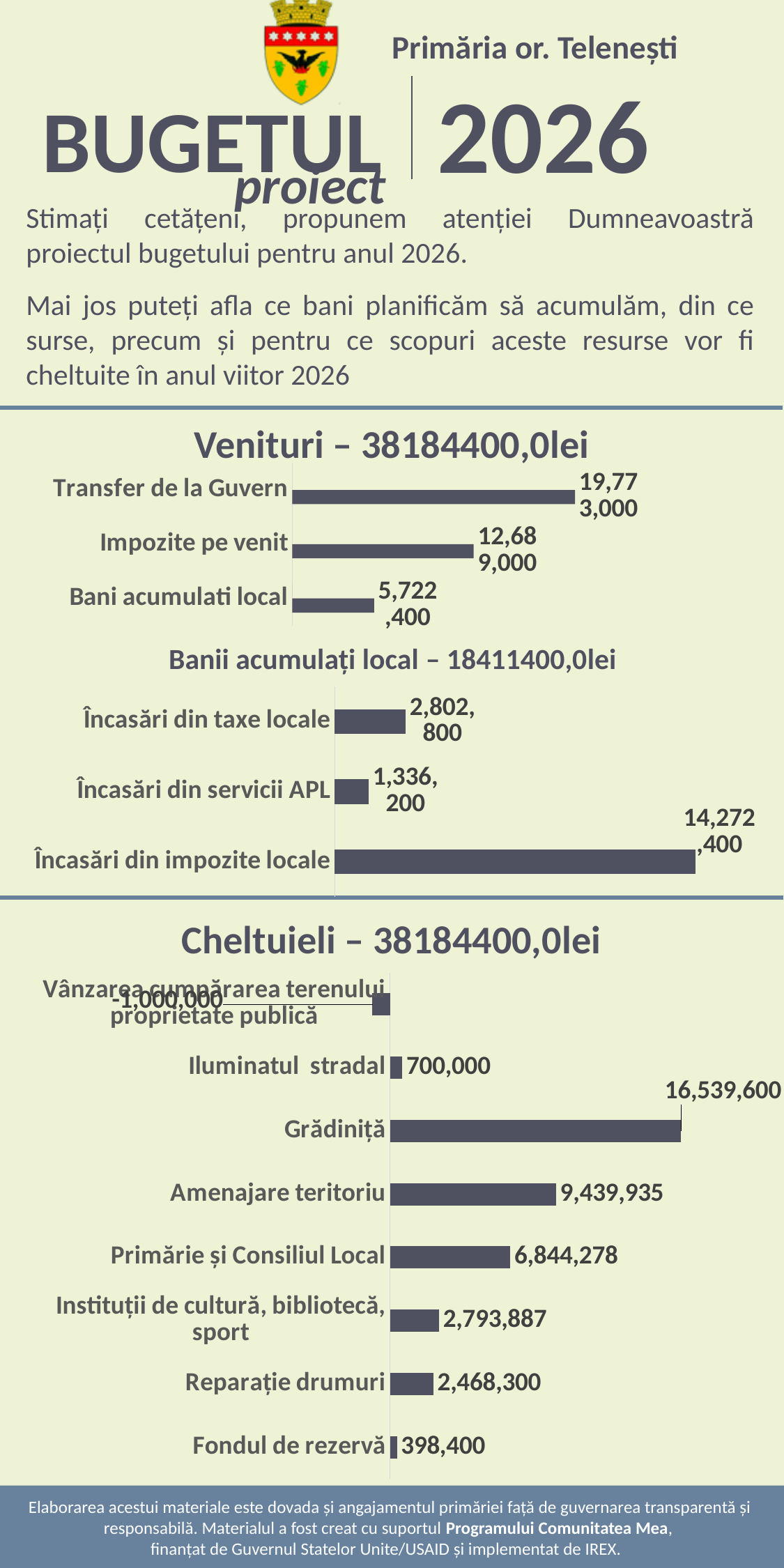
In the 'Cheltuieli' chart, which is larger: Amenajare teritoriu or Primărie și Consiliul Local? Amenajare teritoriu In the 'Cheltuieli' chart, what is the value for Reparație drumuri? 2,468,300 What kind of chart is the 'Cheltuieli' chart? Bar chart In the 'Banii acumulați local' chart, what is the difference between Încasări din taxe locale and Încasări din servicii APL? 1,466,600 In the 'Venituri' chart, which category has the lowest value? Bani acumulati local In the 'Banii acumulați local' chart, what is the value for Încasări din servicii APL? 1,336,200 In the 'Cheltuieli' chart, what is the value for Grădiniță? 16,539,600 In the 'Venituri' chart, how many categories are shown? 3 In the 'Banii acumulați local' chart, which category has the highest value? Încasări din impozite locale In the 'Venituri' chart, what is the value for Impozite pe venit? 12,689,000 In the 'Cheltuieli' chart, how many categories are shown? 8 In the 'Venituri' chart, what is the value for Transfer de la Guvern? 19,773,000